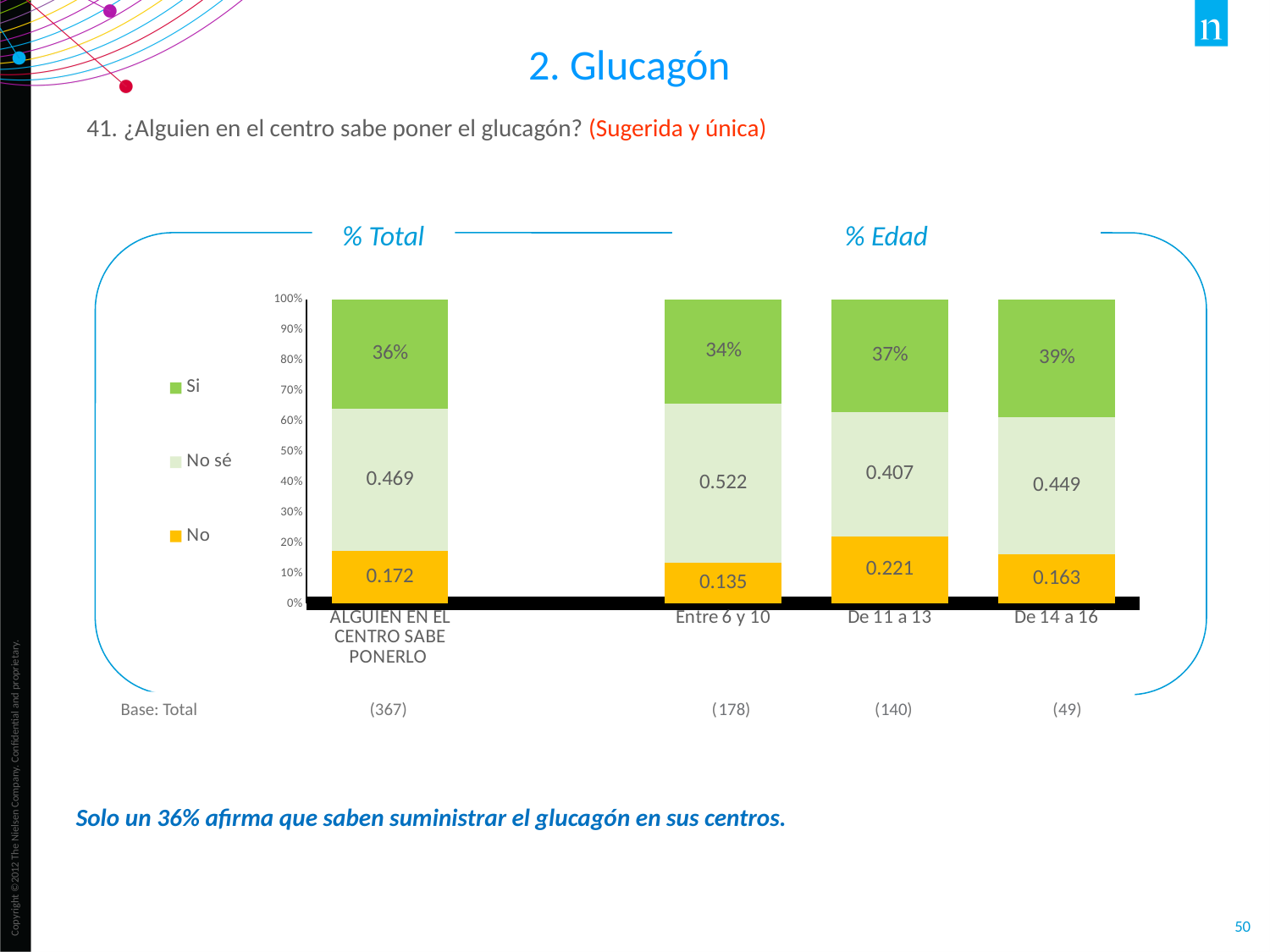
Which category has the lowest 'No' value? Entre 6 y 10 Which is larger, the 'No sé' value for 'De 11 a 13' or for 'De 14 a 16'? De 14 a 16 How many series does the chart legend list? 3 How many categories are plotted along the x axis of the chart? 4 What is the value of the 'Si' segment for the 'De 14 a 16' category? 39% What is the value of the 'No' segment for the 'ALGUIEN EN EL CENTRO SABE PONERLO' category? 0.172 Which legend entry is shown in yellow? No What is the value of the 'No' segment for the 'De 11 a 13' category? 0.221 What is the value of the 'No sé' segment for the 'Entre 6 y 10' category? 0.522 What kind of chart is shown on the slide? Stacked bar chart Which category has the highest 'Si' value? De 14 a 16 What is the difference between the 'No' values for 'De 11 a 13' and 'Entre 6 y 10'? 0.086